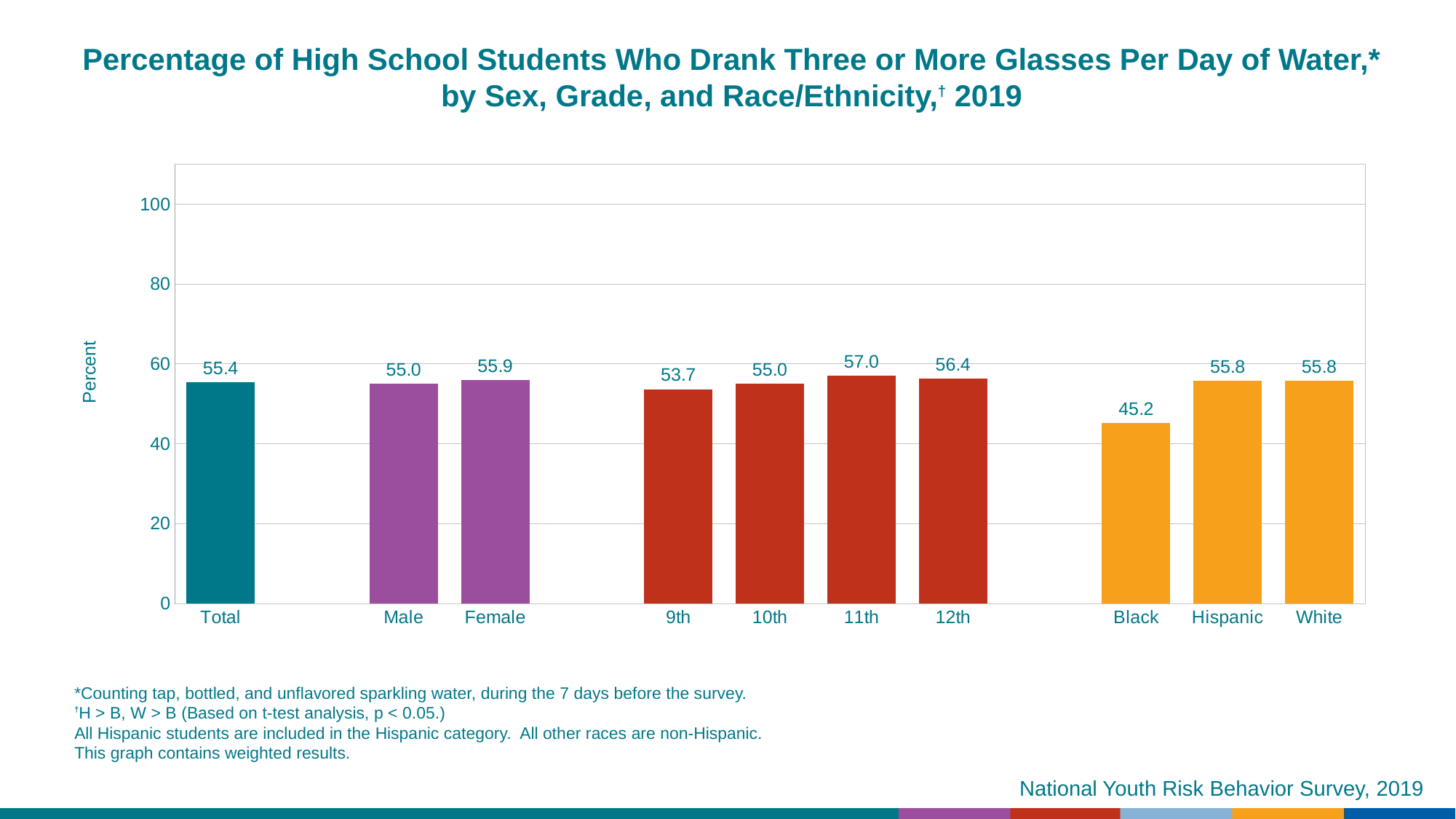
What is the value for Total? 55.4 What is the difference between the Female and Male values? 0.9 How many categories are shown on the x axis? 10 Which is larger, the value for 9th grade or 12th grade? 12th What is the value for Black students? 45.2 Is the value for Black greater or less than 60? less What is the value for 11th grade? 57.0 Which category has the lowest value? Black What is the label of the y axis? Percent Which category has the highest value? 11th What is the difference between the White and Black values? 10.6 What kind of chart is this? bar chart